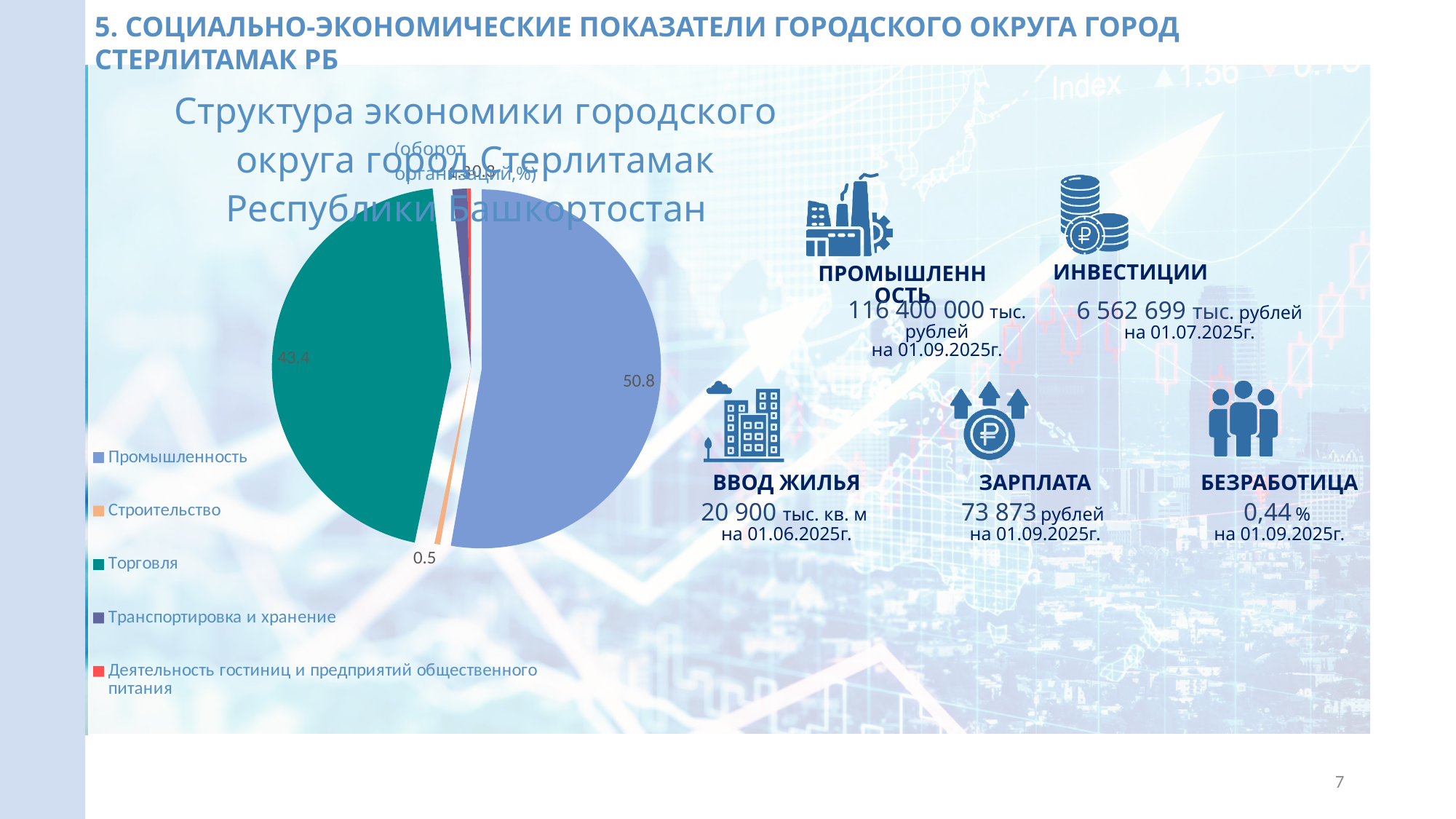
Which is larger in the pie chart, Промышленность or Торговля? Промышленность What value is shown for Строительство in the pie chart? 0.5 What share does Промышленность have in the pie chart? 50.8 What colour represents Торговля in the pie chart? Green (teal) How many categories does the pie chart's legend list? 5 What is the difference between the values for Промышленность and Торговля in the pie chart? 7.4 Which category has the largest slice in the pie chart? Промышленность What is the title of the pie chart? Структура экономики городского округа город Стерлитамак Республики Башкортостан Which is larger in the pie chart, Строительство or Торговля? Торговля What value is shown for Торговля in the pie chart? 43.4 What type of chart is shown on the slide? Pie chart